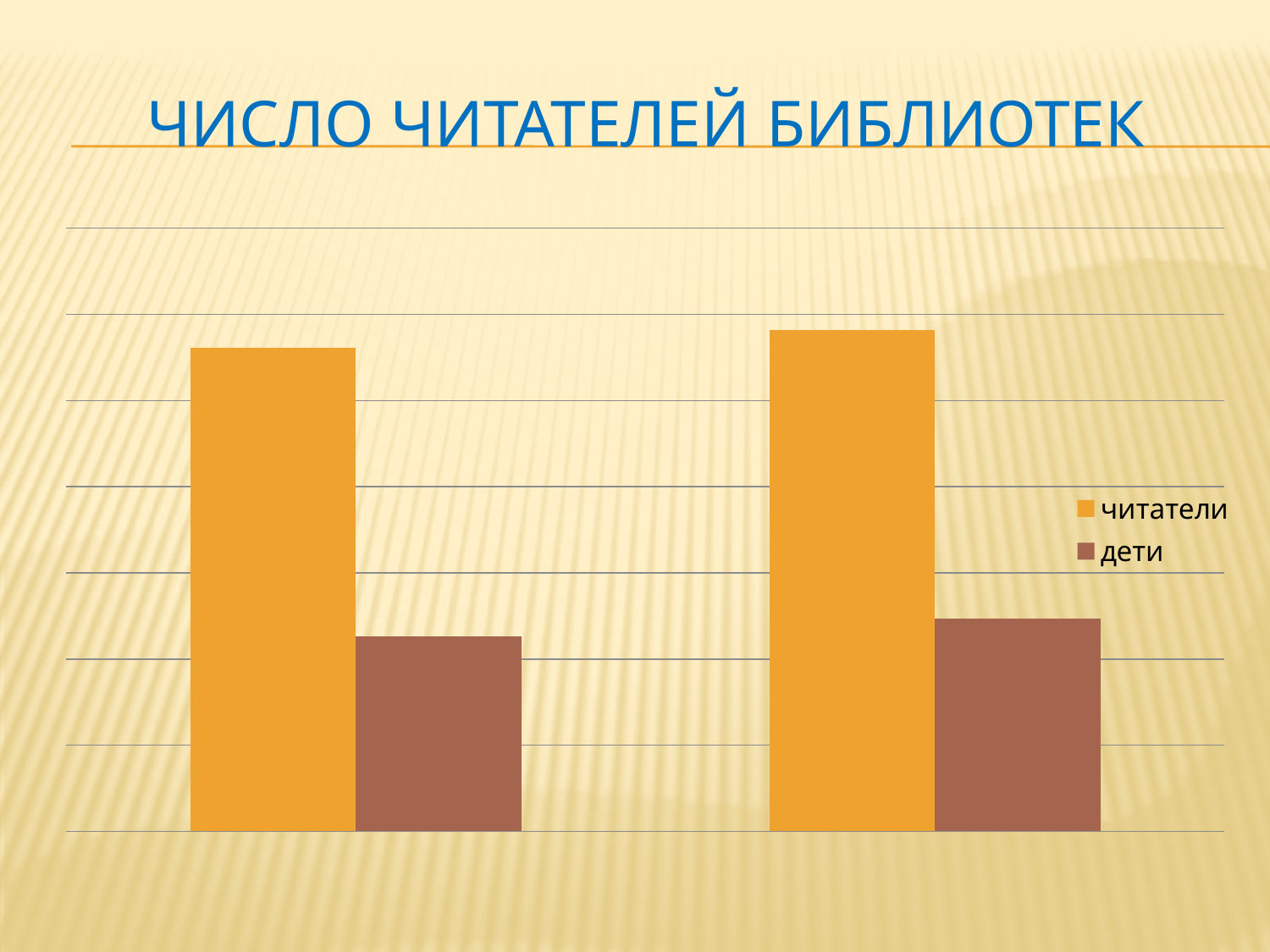
What kind of chart is shown on the slide? bar chart How many groups of bars are plotted on the chart? 2 In the left group of bars, which series has the taller bar, читатели or дети? читатели Which series is shown in orange according to the legend? читатели How many series does the legend list? 2 In the right group of bars, which series has the taller bar, читатели or дети? читатели Which series has the highest bar on the chart? читатели What is the title of the chart on the slide? ЧИСЛО ЧИТАТЕЛЕЙ БИБЛИОТЕК Which series has the lowest bar on the chart? дети Do the читатели values rise or fall from the left group to the right group? rise Is the читатели bar taller in the left group or the right group? right group